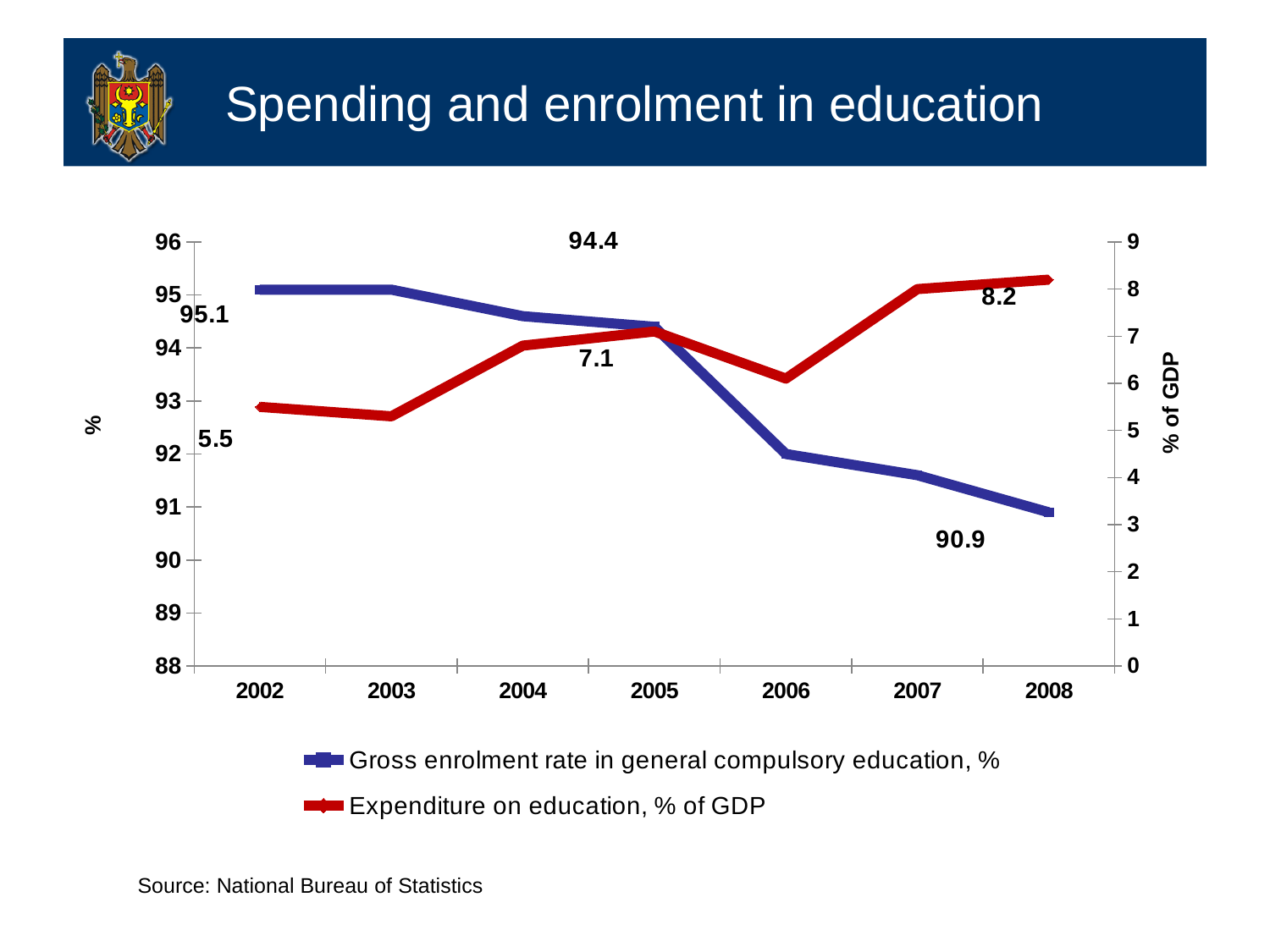
What was expenditure on education as % of GDP in 2002? 5.5 What was expenditure on education as % of GDP in 2008? 8.2 How many series does the legend list? 2 How many years are shown on the x axis? 7 What was the gross enrolment rate in general compulsory education in 2002? 95.1 By how much did expenditure on education (% of GDP) increase between 2002 and 2008? 2.7 Does the gross enrolment rate rise or fall from 2002 to 2008? fall Is the gross enrolment rate in 2007 greater or less than 91? greater Is expenditure on education (% of GDP) in 2003 greater or less than 5? greater What type of chart is shown on the slide? line chart By how much did the gross enrolment rate fall between 2002 and 2008? 4.2 What was the gross enrolment rate in general compulsory education in 2008? 90.9